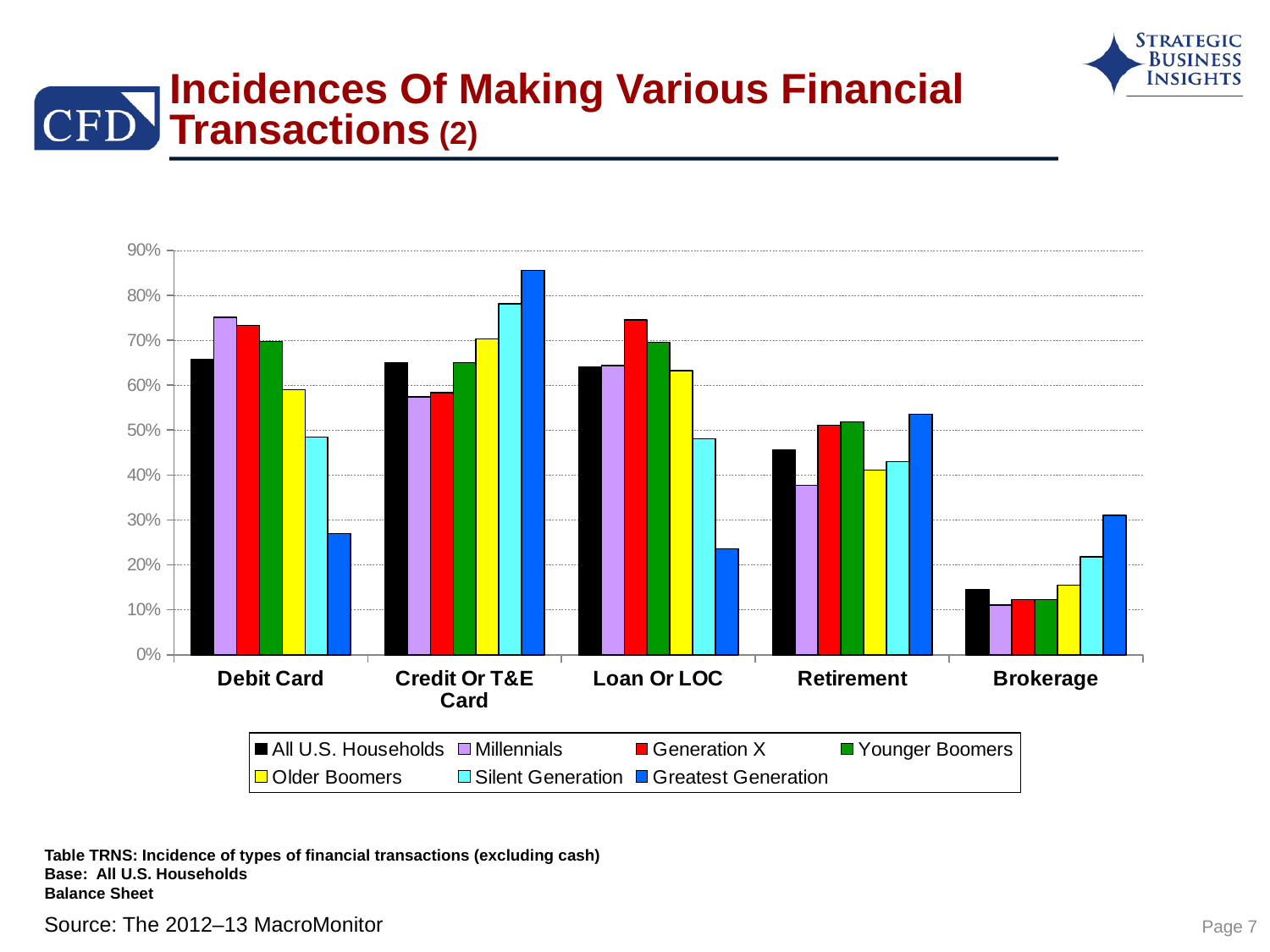
Which series has the highest value for Brokerage? Greatest Generation Which series has the lowest value for Debit Card? Greatest Generation How many transaction categories are shown along the x axis? 5 Which series has the highest value for Credit Or T&E Card? Greatest Generation Is the Greatest Generation value for Debit Card greater or less than 30%? less Is the Greatest Generation value for Brokerage greater or less than 20%? greater How many series does the legend list? 7 For Debit Card, which is larger: Millennials or Older Boomers? Millennials Which series has the lowest value for Loan Or LOC? Greatest Generation What kind of chart is shown on the slide? Bar chart Is the Greatest Generation value for Loan Or LOC greater or less than 30%? less For Retirement, which is larger: Generation X or Millennials? Generation X